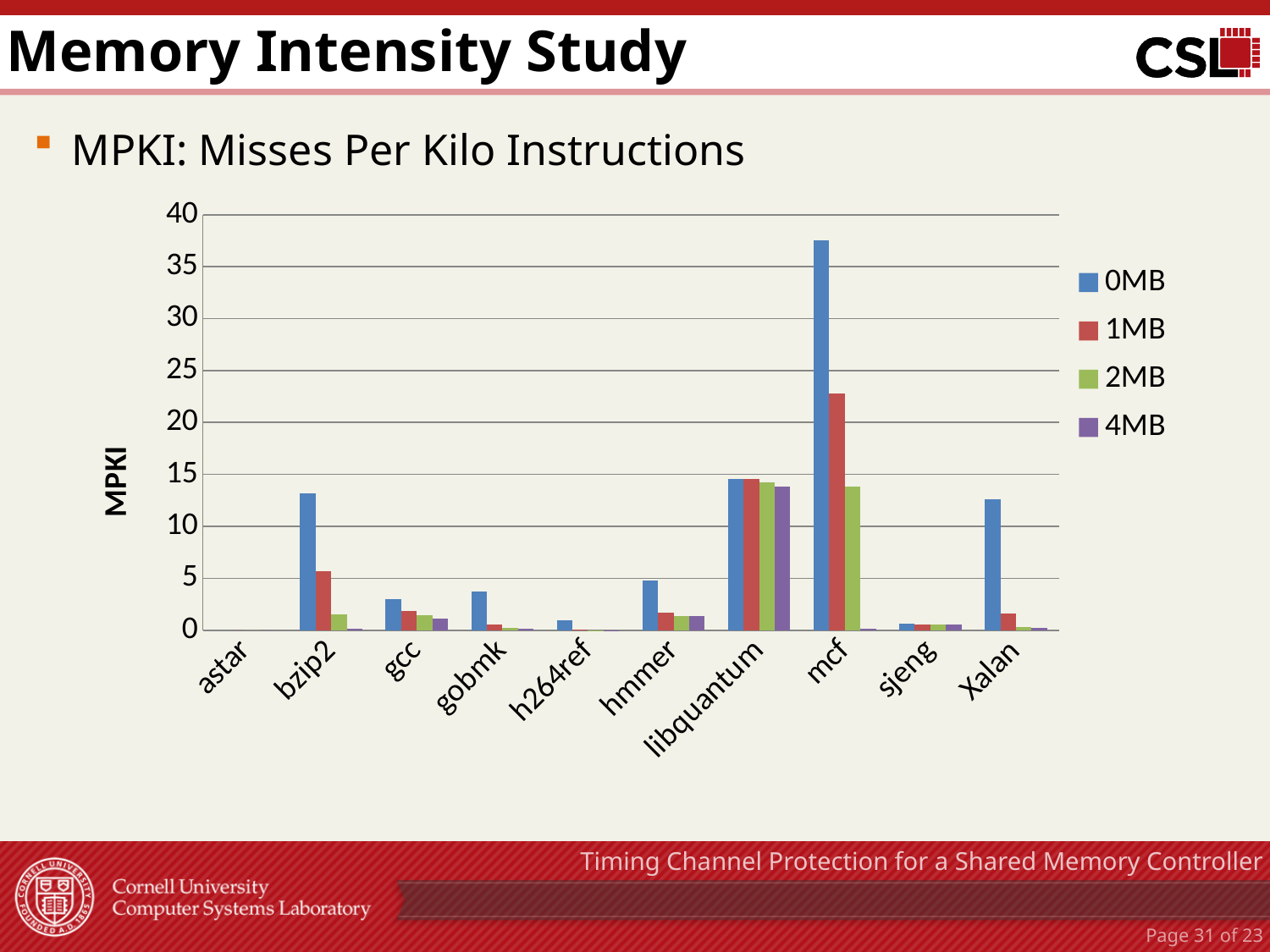
Is the 1MB value for mcf greater or less than 20? greater What kind of chart is shown on the slide? bar chart How many series does the legend list? 4 Is the 0MB value for bzip2 greater or less than 10? greater What is the label on the y axis? MPKI Which is larger, the 0MB value for hmmer or the 0MB value for gcc? hmmer Is the 0MB value for gcc greater or less than 5? less How many benchmark categories are shown on the x axis? 10 Which is larger, the 1MB value for mcf or the 1MB value for libquantum? mcf Which benchmark has the highest MPKI for the 0MB series? mcf